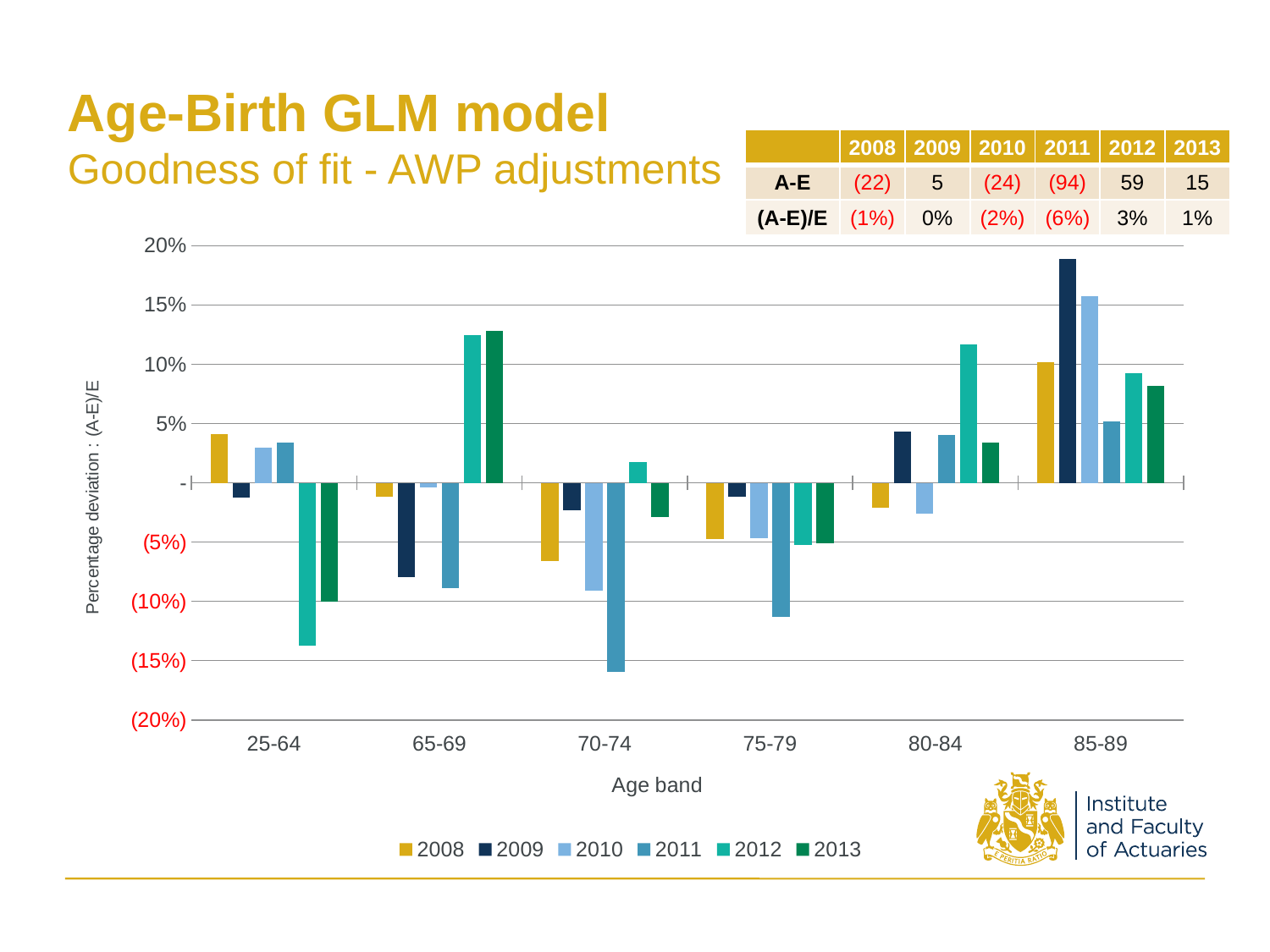
In the 85-89 age band, which is larger, the 2009 bar or the 2010 bar? 2009 What is the title of the chart's vertical axis? Percentage deviation : (A-E)/E Which age band contains the lowest bar in the whole chart? 70-74 What is the title of the chart's horizontal axis? Age band Is the value for 2011 in the 70-74 age band greater or less than (10%)? less Which year has the highest bar in the 85-89 age band? 2009 Which year has the lowest bar in the 25-64 age band? 2012 How many series does the chart's legend list? 6 How many age bands are shown on the x axis of the chart? 6 Is the value for 2012 in the 65-69 age band greater or less than 10%? greater What kind of chart is shown on the slide? bar chart Is the value for 2009 in the 85-89 age band greater or less than 15%? greater